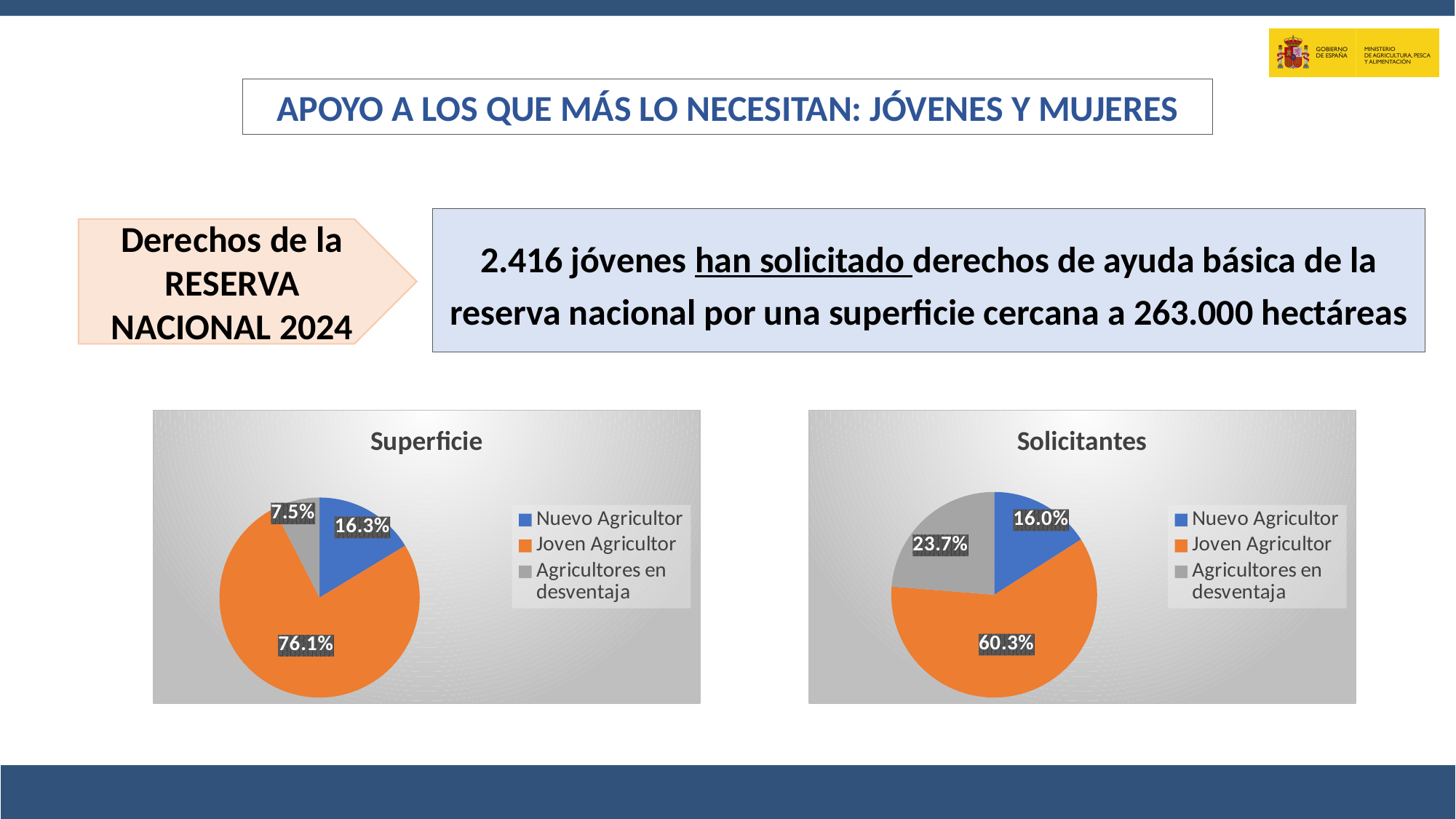
In the 'Superficie' chart, what share does Joven Agricultor have? 76.1% How many categories does the legend of the 'Superficie' chart list? 3 In the 'Superficie' chart, what is the value for Agricultores en desventaja? 7.5% In the 'Superficie' chart, which is larger: Nuevo Agricultor or Agricultores en desventaja? Nuevo Agricultor In the 'Solicitantes' chart, what is the value for Nuevo Agricultor? 16.0% What type of chart is the 'Solicitantes' chart? Pie chart In the 'Superficie' chart, what is the value for Nuevo Agricultor? 16.3% In the 'Solicitantes' chart, what is the difference between Agricultores en desventaja and Nuevo Agricultor? 7.7% In the 'Solicitantes' chart, what share does Joven Agricultor have? 60.3% In the 'Solicitantes' chart, which category has the largest slice? Joven Agricultor In the 'Solicitantes' chart, what is the value for Agricultores en desventaja? 23.7% In the 'Superficie' chart, which category has the smallest slice? Agricultores en desventaja